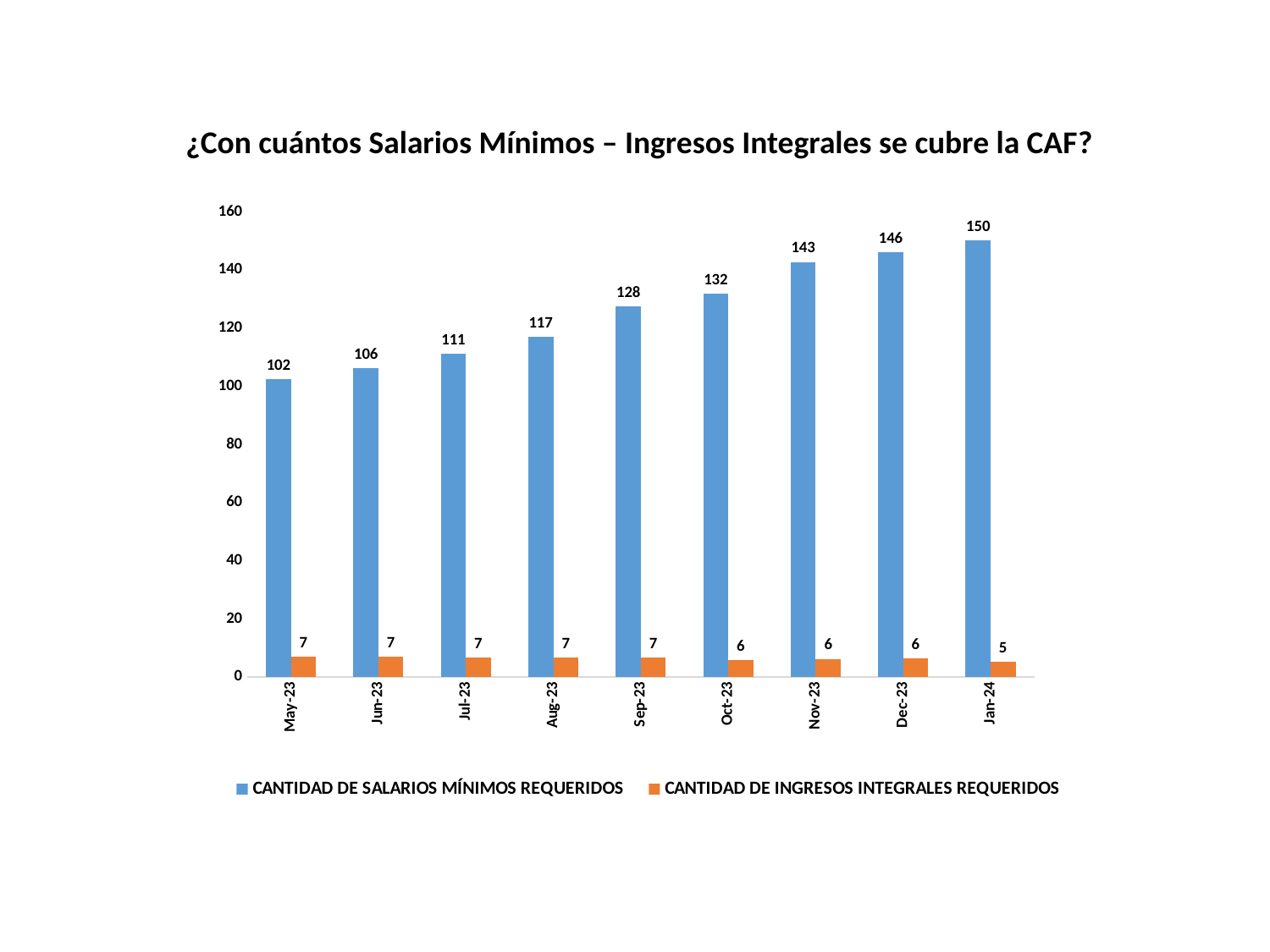
What colour are the bars for CANTIDAD DE INGRESOS INTEGRALES REQUERIDOS? Orange How many series does the legend list? 2 What is the value of CANTIDAD DE SALARIOS MÍNIMOS REQUERIDOS for Sep-23? 128 Which is larger, the CANTIDAD DE SALARIOS MÍNIMOS REQUERIDOS value for Oct-23 or for Nov-23? Nov-23 Do the CANTIDAD DE SALARIOS MÍNIMOS REQUERIDOS values rise or fall from May-23 to Jan-24? Rise What kind of chart is shown on the slide? Bar chart What is the value of CANTIDAD DE INGRESOS INTEGRALES REQUERIDOS for Jan-24? 5 Which month has the lowest value for CANTIDAD DE SALARIOS MÍNIMOS REQUERIDOS? May-23 What is the value of CANTIDAD DE SALARIOS MÍNIMOS REQUERIDOS for May-23? 102 What is the difference between the CANTIDAD DE SALARIOS MÍNIMOS REQUERIDOS values for Jan-24 and May-23? 48 Which month has the highest value for CANTIDAD DE SALARIOS MÍNIMOS REQUERIDOS? Jan-24 How many months are shown on the x axis? 9